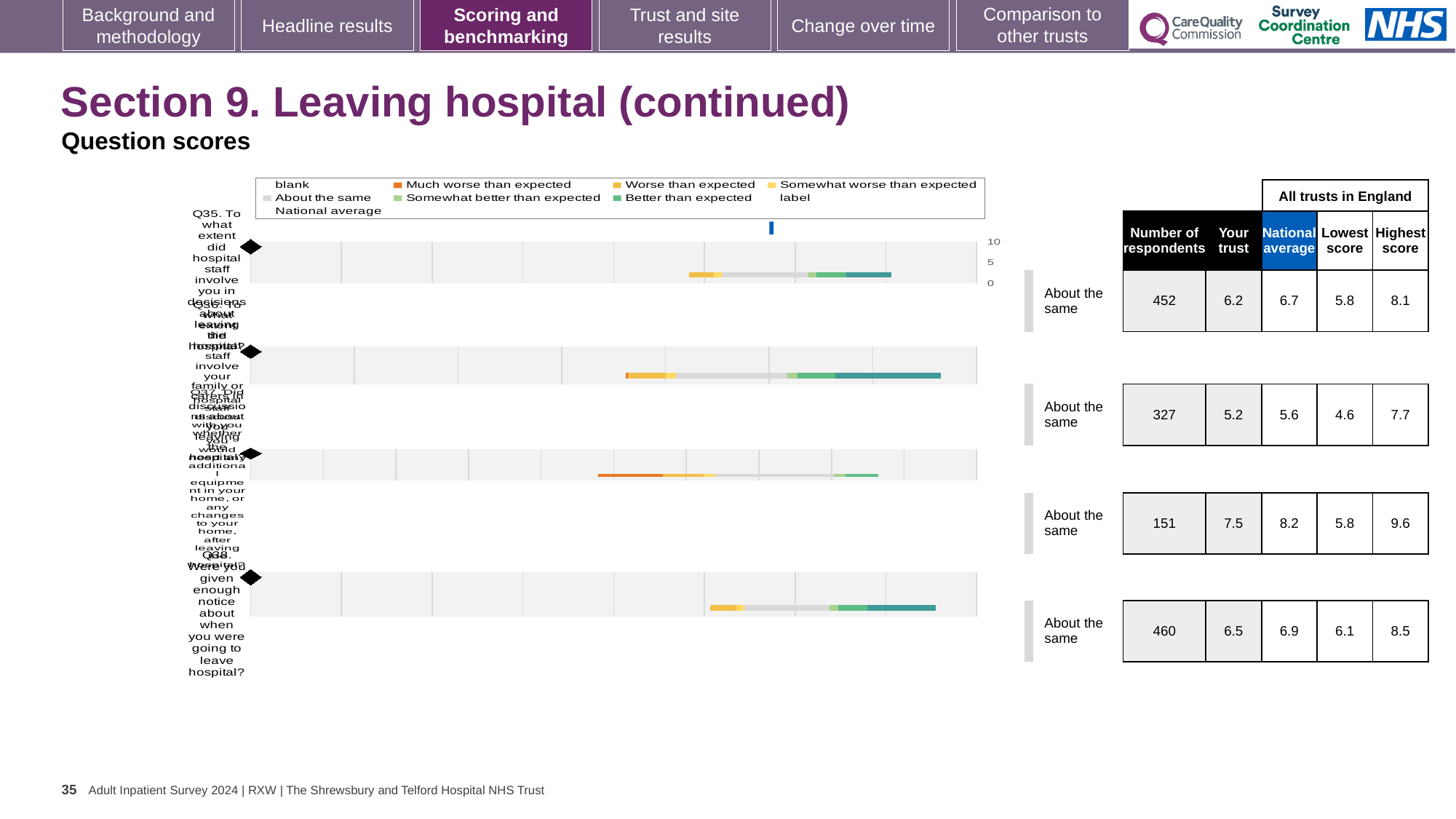
For the top chart (Q35), what is the number of respondents shown in the table? 452 In the chart legend, what colour represents "Much worse than expected"? orange Which chart row has the highest "Highest score" value in the table? the third chart from the top (9.6) Which chart row has the lowest number of respondents in the table? the third chart from the top (151) What kind of chart is used to show the question scores on this slide? bar chart For the top chart (Q35), is the "Your trust" score higher or lower than the national average? lower For the bottom chart (Q38), what is the difference between the national average and the "Your trust" score? 0.4 For the top chart (Q35), what is the national average shown in the table? 6.7 For the bottom chart (Q38), what is the "Your trust" score shown in the table? 6.5 What benchmark category is shown next to each of the four charts? About the same In the chart legend, which category is shown in dark teal? Better than expected How many question charts are shown on the slide? 4